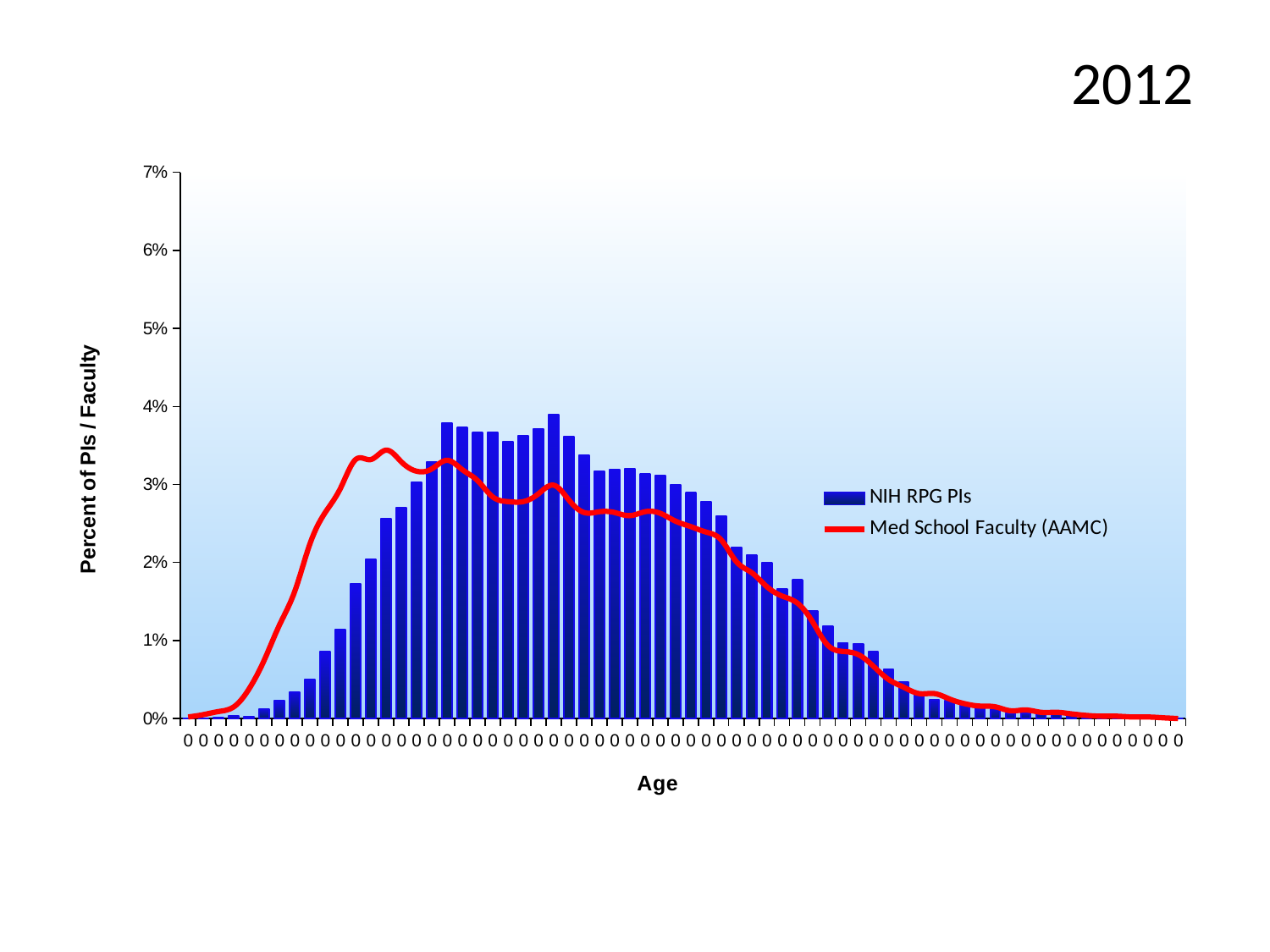
What is the title of the y axis? Percent of PIs / Faculty Is the peak of the Med School Faculty (AAMC) line greater or less than 3%? greater What kind of chart is shown on the slide? A combined bar and line chart How many series does the legend list? 2 What is the title of the x axis? Age Is the tallest bar for NIH RPG PIs greater or less than 3%? greater Which series is drawn as a red line? Med School Faculty (AAMC) Toward the right end of the x axis, do the NIH RPG PIs bars rise or fall? fall What year is shown as the slide title? 2012 Which series is drawn as bars? NIH RPG PIs Is the tallest bar for NIH RPG PIs greater or less than 5%? less What is the highest tick value shown on the y axis? 7%